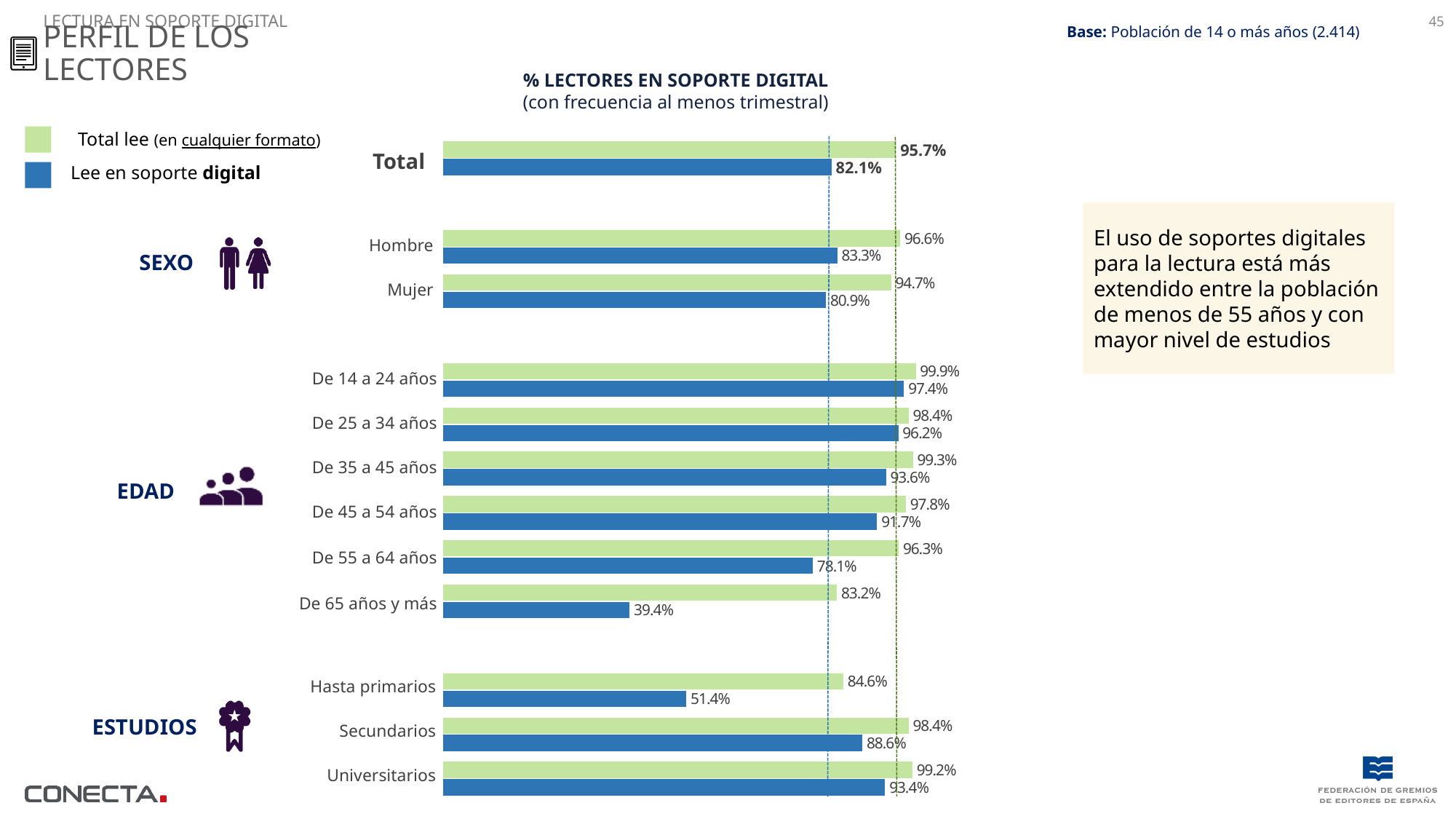
Which has a higher 'Lee en soporte digital' value, Secundarios or Universitarios? Universitarios What is the 'Lee en soporte digital' value for De 65 años y más? 39.4% What is the difference between 'Total lee' and 'Lee en soporte digital' for the Total category? 13.6 percentage points How many series does the legend list? 2 What is the 'Lee en soporte digital' value for Hasta primarios? 51.4% What is the difference between the 'Lee en soporte digital' values for Hombre and Mujer? 2.4 percentage points Which category has the lowest 'Lee en soporte digital' value? De 65 años y más What is the value of 'Total lee (en cualquier formato)' for Mujer? 94.7% How many categories are plotted in the chart? 12 What is the value of 'Lee en soporte digital' for the Total category? 82.1% What kind of chart is shown on the slide? Bar chart Which category has the highest 'Lee en soporte digital' value? De 14 a 24 años